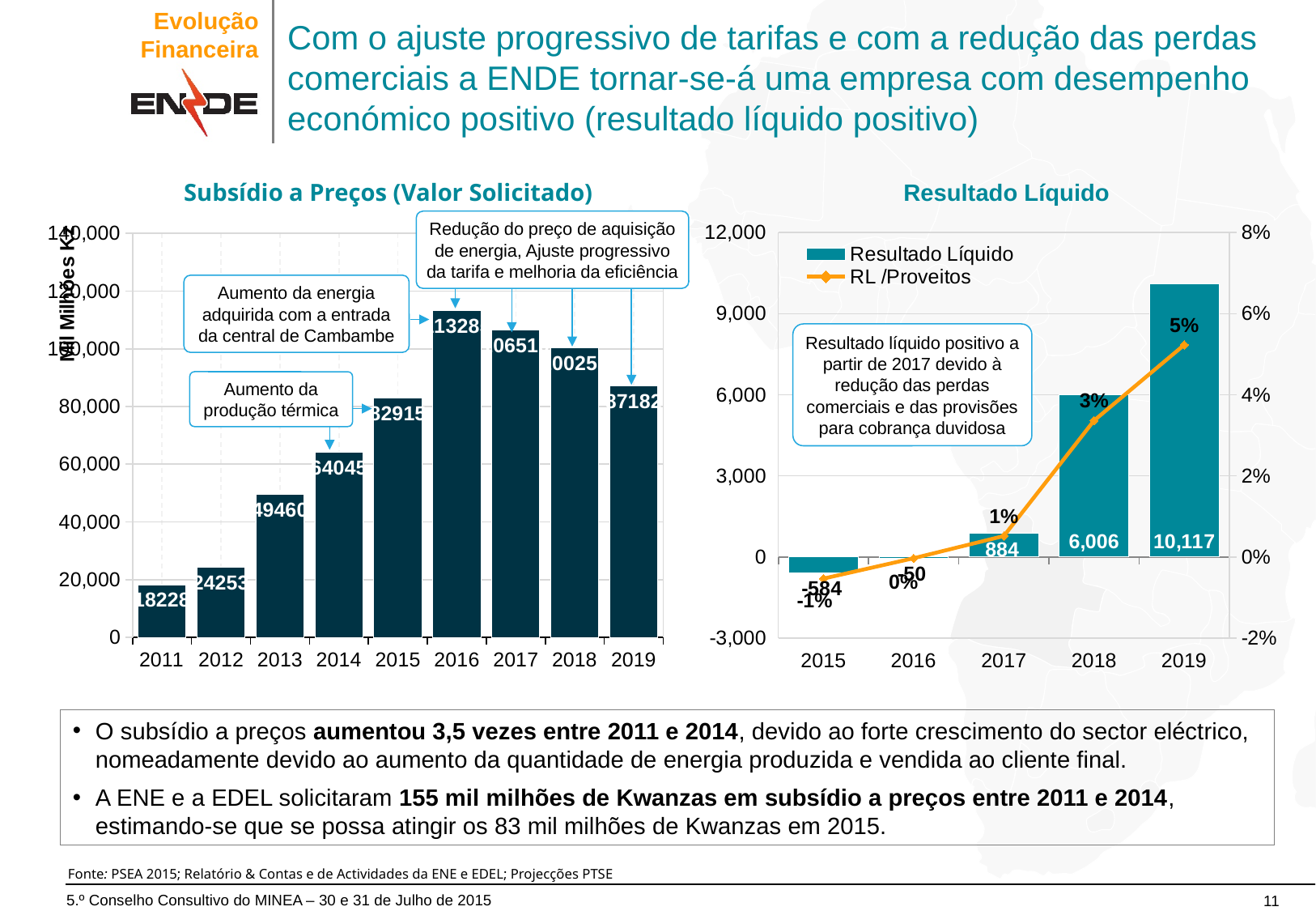
In the Subsídio a Preços (Valor Solicitado) chart, what is the difference between the values for 2014 and 2013? 14585 In the Subsídio a Preços (Valor Solicitado) chart, what is the value for 2015? 82915 In the Resultado Líquido chart, what is the RL /Proveitos value for 2017? 1% In the Subsídio a Preços (Valor Solicitado) chart, what is the value for 2011? 18228 In the Resultado Líquido chart, what is the difference between the Resultado Líquido values for 2019 and 2018? 4,111 How many years are shown on the x axis of the Subsídio a Preços (Valor Solicitado) chart? 9 In the Resultado Líquido chart, what is the Resultado Líquido value for 2019? 10,117 How many series does the legend of the Resultado Líquido chart list? 2 In the Subsídio a Preços (Valor Solicitado) chart, is the value for 2017 greater or less than 100,000? greater In the Subsídio a Preços (Valor Solicitado) chart, which year has the highest bar? 2016 In the Resultado Líquido chart, does the Resultado Líquido rise or fall from 2015 to 2019? rise In the Subsídio a Preços (Valor Solicitado) chart, which year has the lowest value? 2011